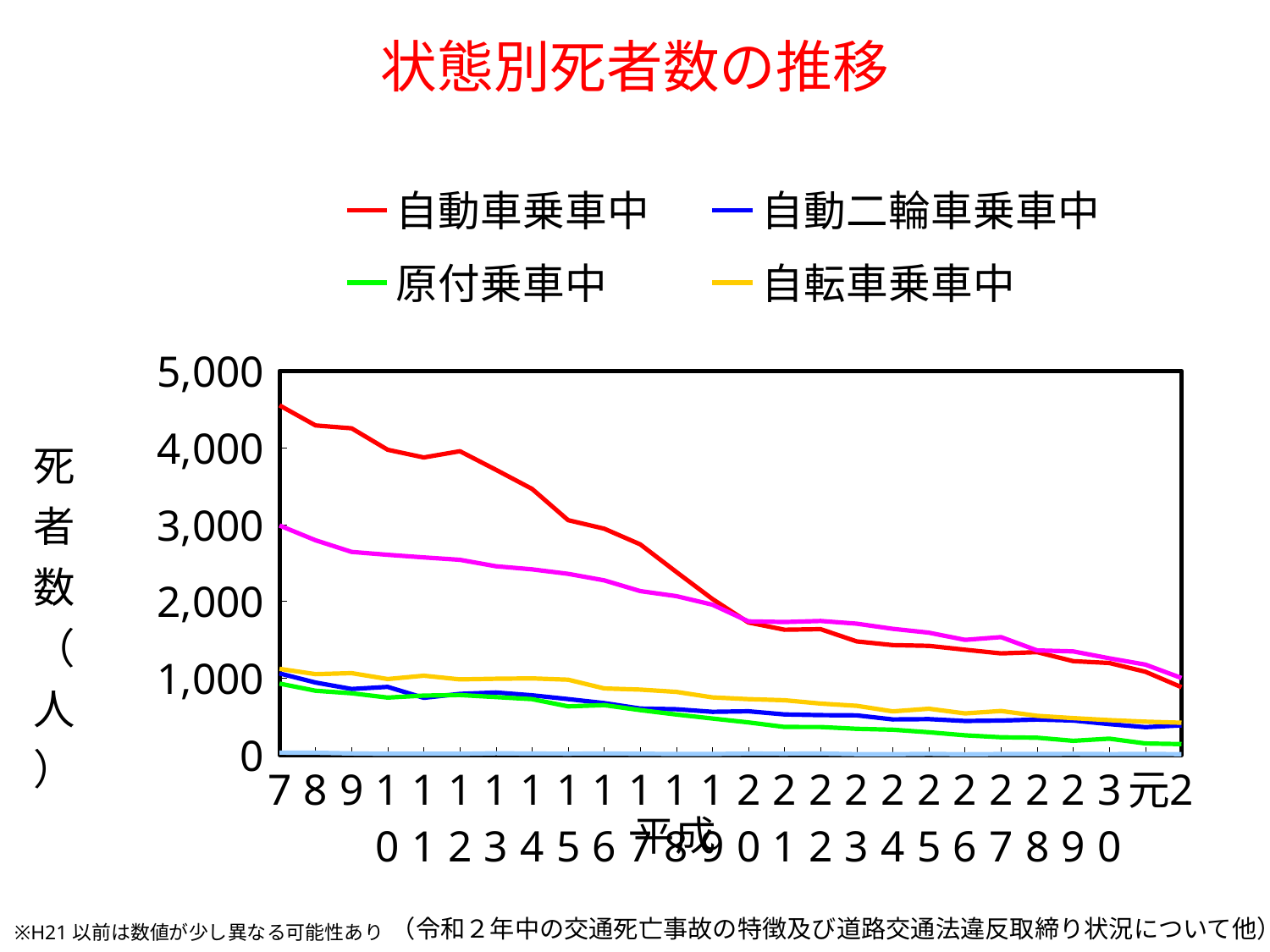
How many series does the legend list? 4 What is the title of the chart? 状態別死者数の推移 Which colour is used for the 自動車乗車中 series? red Which series has the highest value in 平成7? 自動車乗車中 Is the value for 自動車乗車中 in 平成7 greater or less than 4,000? greater Is the value for 自動車乗車中 in 平成20 greater or less than 1,500? greater What kind of chart is shown on the slide? line chart Does the 自動車乗車中 series rise or fall from 平成7 to 令和2? fall Does the 原付乗車中 series rise or fall from 平成7 to 令和2? fall In 令和2, which is larger: 自転車乗車中 or 原付乗車中? 自転車乗車中 Is the value for 原付乗車中 in 令和2 greater or less than 500? less